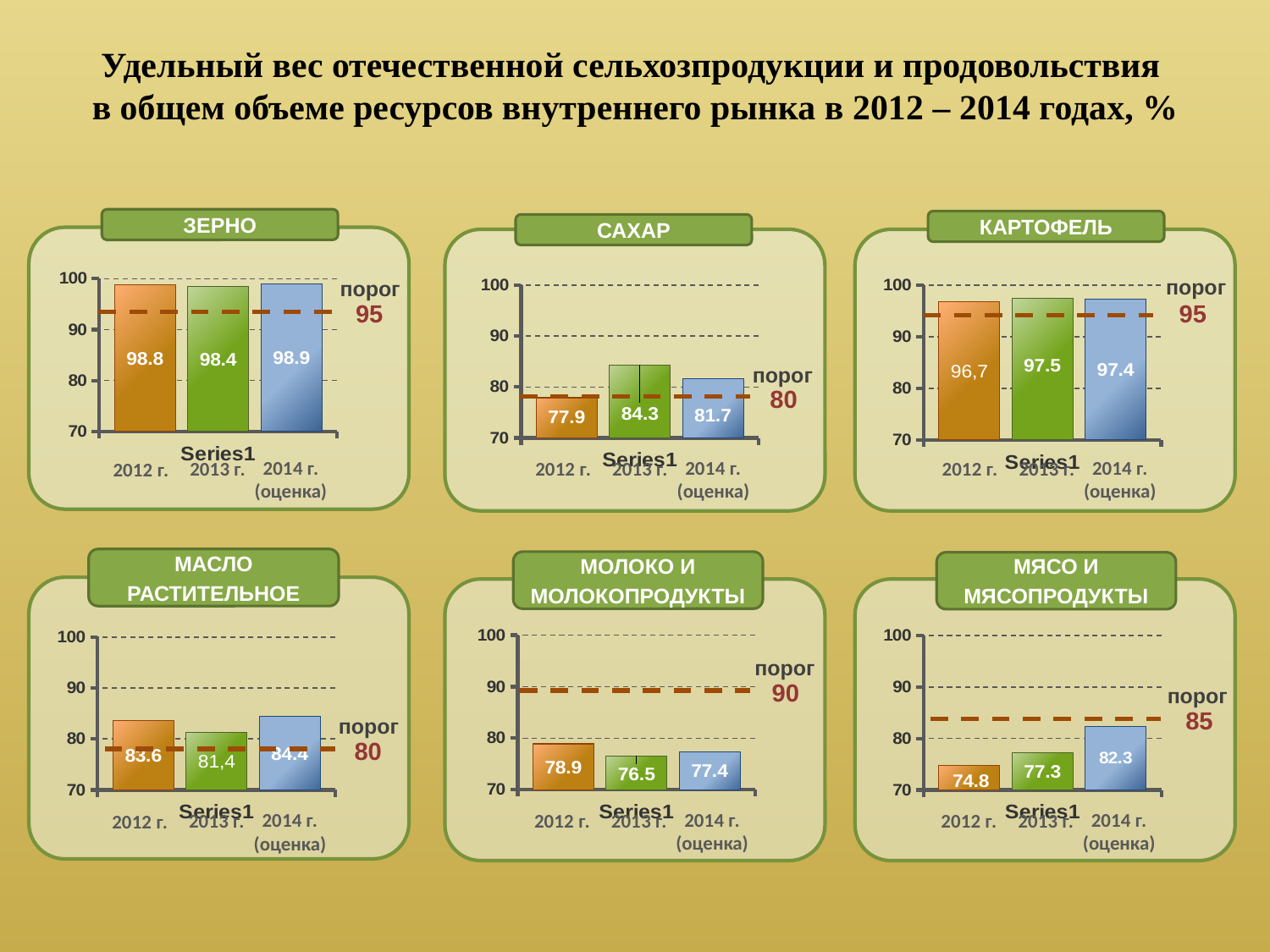
What kind of chart is the САХАР chart? bar chart In the МАСЛО РАСТИТЕЛЬНОЕ chart, which year has the lowest value? 2013 г. In the ЗЕРНО chart, what is the value for 2014 г. (оценка)? 98.9 In the САХАР chart, which year has the highest value? 2013 г. In the МЯСО И МЯСОПРОДУКТЫ chart, what is the value for 2014 г. (оценка)? 82.3 In the КАРТОФЕЛЬ chart, what is the value for 2012 г.? 96,7 In the МЯСО И МЯСОПРОДУКТЫ chart, do the values rise or fall from 2012 г. to 2014 г. (оценка)? rise What threshold (порог) value is marked on the МОЛОКО И МОЛОКОПРОДУКТЫ chart? 90 In the МОЛОКО И МОЛОКОПРОДУКТЫ chart, is the value for 2012 г. larger or smaller than the value for 2014 г. (оценка)? larger How many charts are shown on the slide? 6 How many bars are plotted in the ЗЕРНО chart? 3 In the САХАР chart, what is the difference between the 2013 г. value and the 2012 г. value? 6.4